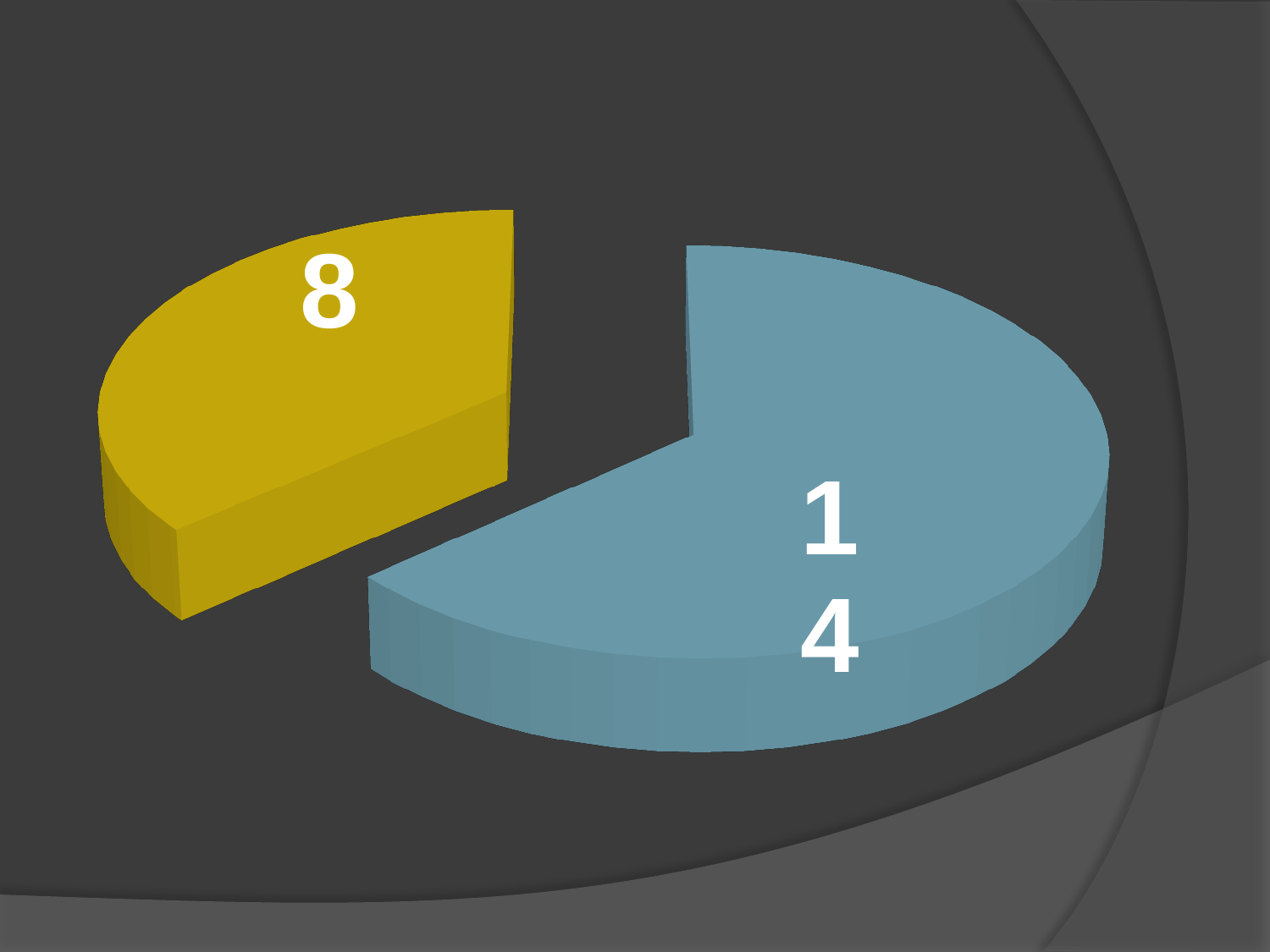
What value is labelled on the blue slice of the pie chart? 14 Which slice of the pie chart has the larger value, the yellow one or the blue one? the blue one What kind of chart is shown on the slide? pie chart Does the pie chart have a legend? no What is the total of the two slice values in the pie chart? 22 How many slices does the pie chart have? 2 What share of the pie does the yellow slice represent, based on the labelled values? 36.4% Which slice of the pie chart has the smaller value, the yellow one or the blue one? the yellow one What value is labelled on the yellow slice of the pie chart? 8 What colour is the slice labelled 8? yellow Is the value of the blue slice larger than the value of the yellow slice? yes What is the difference between the blue slice's value and the yellow slice's value? 6